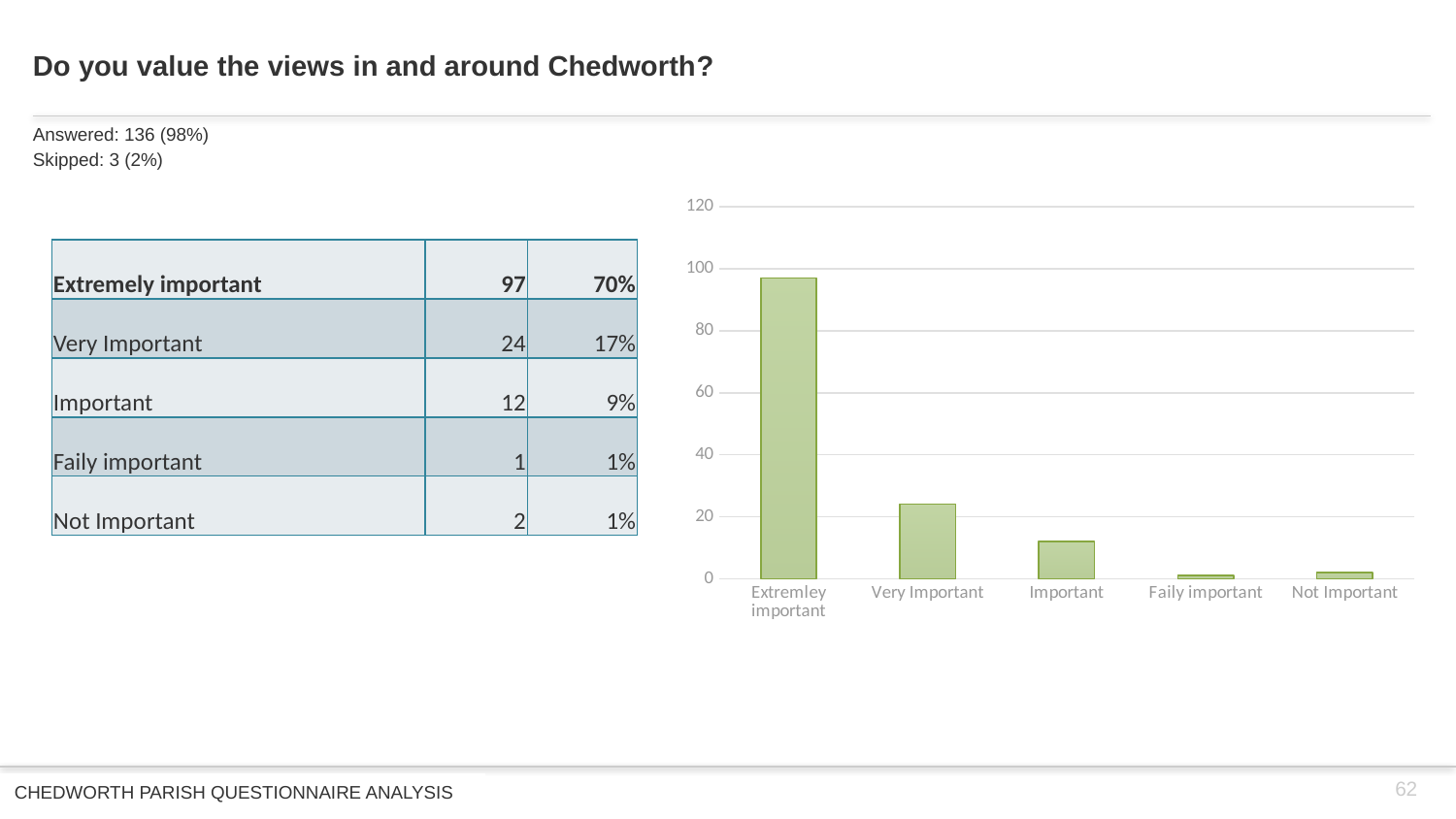
Which category has the highest bar in the chart? Extremely important What is the difference between the counts for 'Extremely important' and 'Very Important'? 73 Which category has the lowest bar in the chart? Faily important What kind of chart is shown on the slide? bar chart Is the value for 'Extremely important' greater or less than 80? greater Do the bar values rise or fall from left to right across the first three categories? fall Which is larger, the value for 'Important' or the value for 'Not Important'? Important According to the table, how many respondents answered 'Extremely important'? 97 How many categories are shown on the x axis of the chart? 5 What percentage of respondents answered 'Important'? 9% Is the value for 'Very Important' greater or less than 40? less According to the table, how many respondents answered 'Very Important'? 24